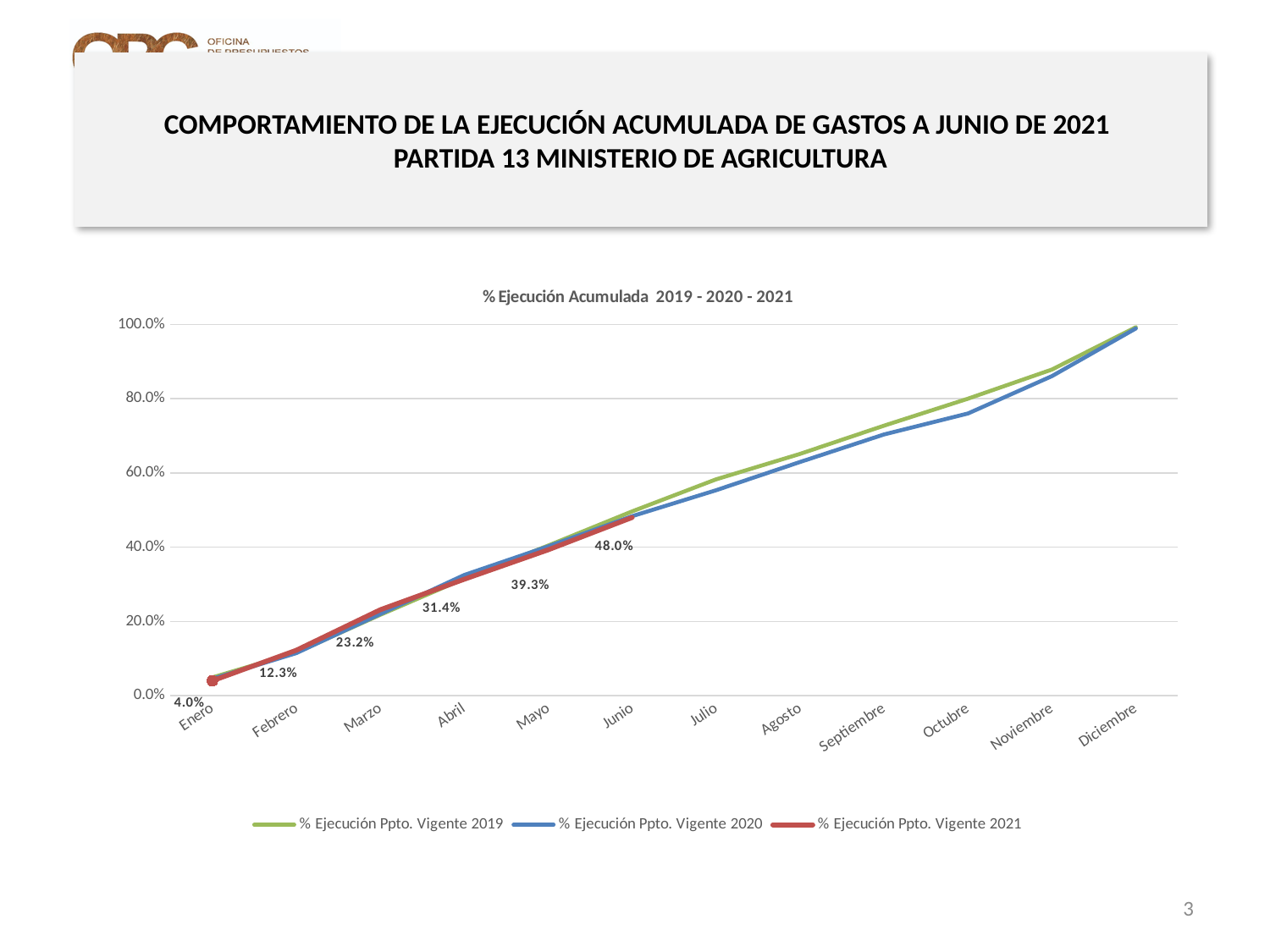
Do the values of the series rise or fall from Enero to Diciembre? Rise How many months are shown on the x axis? 12 What is the difference between the 2021 values for Junio and Mayo? 8.7 percentage points What is the value of % Ejecución Ppto. Vigente 2021 for Enero? 4.0% How many series does the legend list? 3 Is the value for % Ejecución Ppto. Vigente 2020 in Septiembre greater or less than 80.0%? less What kind of chart is shown on the slide? Line chart Which month has the highest value for % Ejecución Ppto. Vigente 2021? Junio What is the value of % Ejecución Ppto. Vigente 2021 for Marzo? 23.2% Which month has the lowest value for % Ejecución Ppto. Vigente 2021? Enero What is the value of % Ejecución Ppto. Vigente 2021 for Junio? 48.0% What is the value of % Ejecución Ppto. Vigente 2021 for Abril? 31.4%